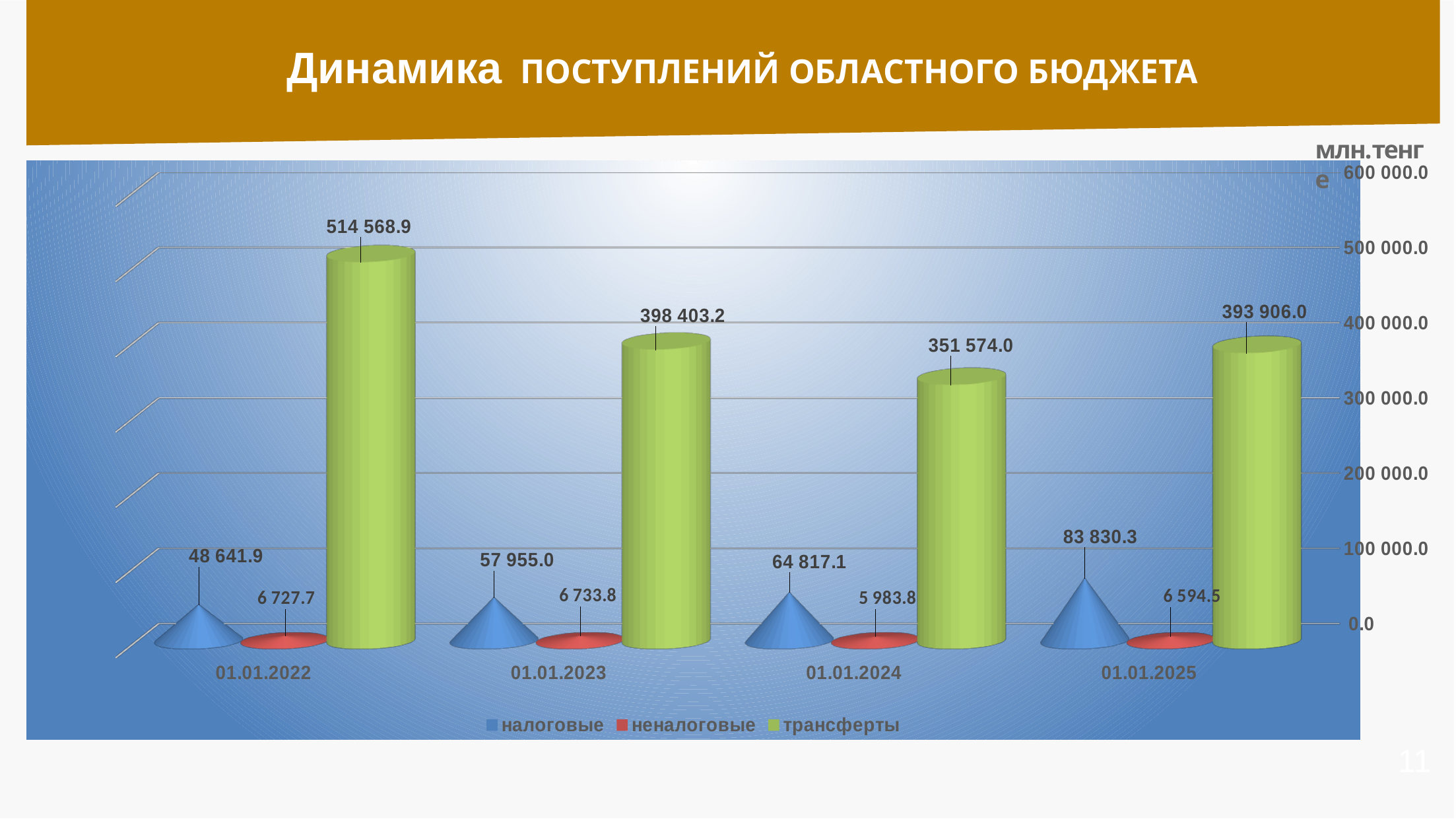
What is the value for трансферты on 01.01.2022? 514 568.9 What is the difference between the трансферты values on 01.01.2022 and 01.01.2023? 116 165.7 How many dates are shown on the x axis? 4 What is the value for неналоговые on 01.01.2024? 5 983.8 Which is larger: the налоговые value on 01.01.2023 or on 01.01.2024? 01.01.2024 How many series does the legend list? 3 What is the value for налоговые on 01.01.2025? 83 830.3 On which date is the value for трансферты the lowest? 01.01.2024 Do the налоговые values rise or fall from 01.01.2022 to 01.01.2025? rise Is the value for трансферты on 01.01.2024 greater or less than 300 000.0? greater On which date is the value for трансферты the highest? 01.01.2022 On which date is the value for налоговые the highest? 01.01.2025